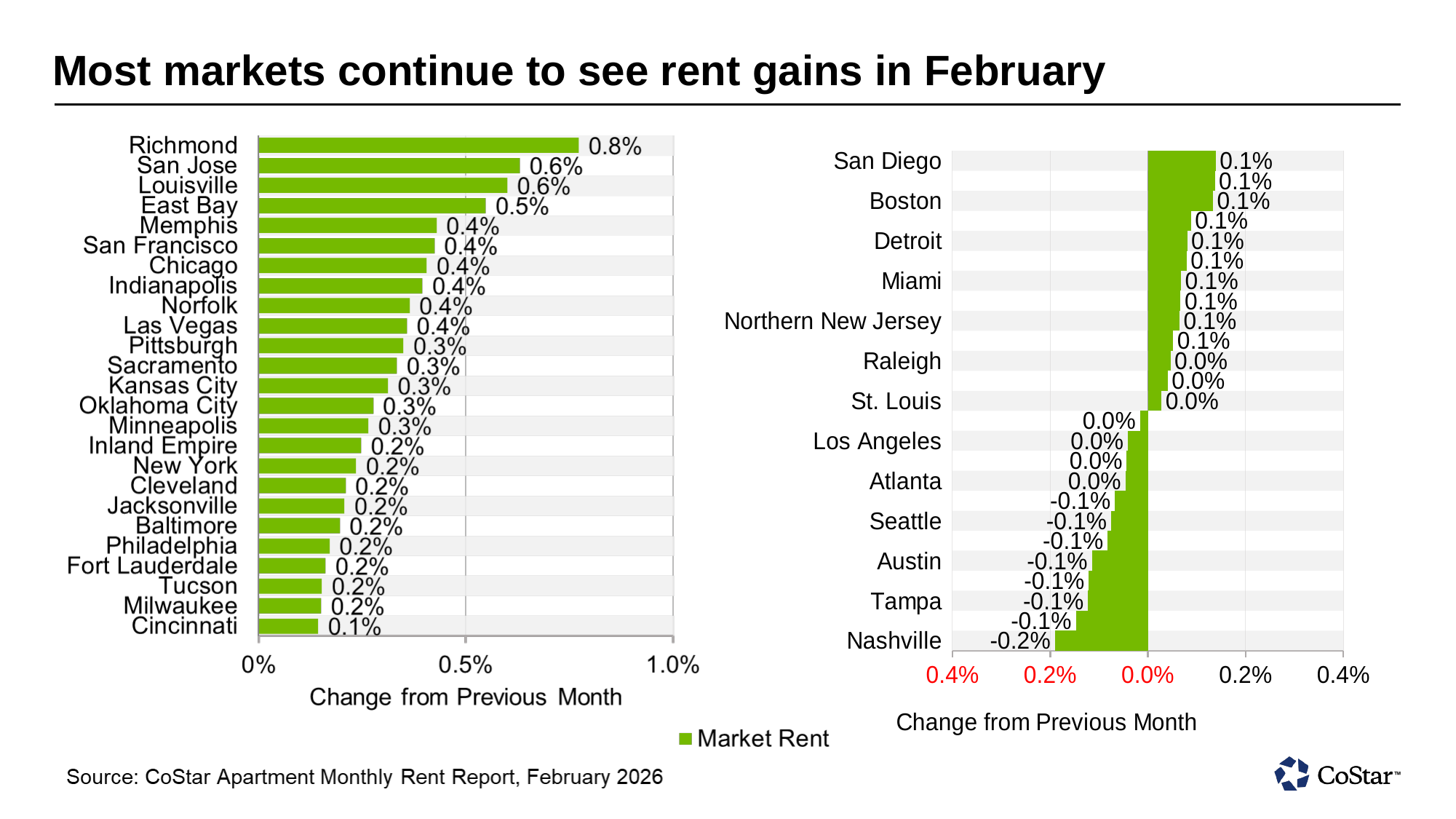
In the left chart, what is the change from previous month for Cincinnati? 0.1% In the left chart, is the value for Richmond greater or less than 0.5%? greater In the right chart, which labeled market has the lowest change from previous month? Nashville In the left chart, what is the difference between Richmond's and Cincinnati's change from previous month? 0.7% What kind of chart is the left chart? Bar chart In the left chart, what is the change from previous month for Richmond? 0.8% How many markets are listed in the left chart? 25 How many series does the legend list? 1 In the left chart, which market has the highest change from previous month? Richmond In the left chart, which has a larger change from previous month, Richmond or East Bay? Richmond In the right chart, what is the change from previous month for Nashville? -0.2% In the left chart, which market has the lowest change from previous month? Cincinnati